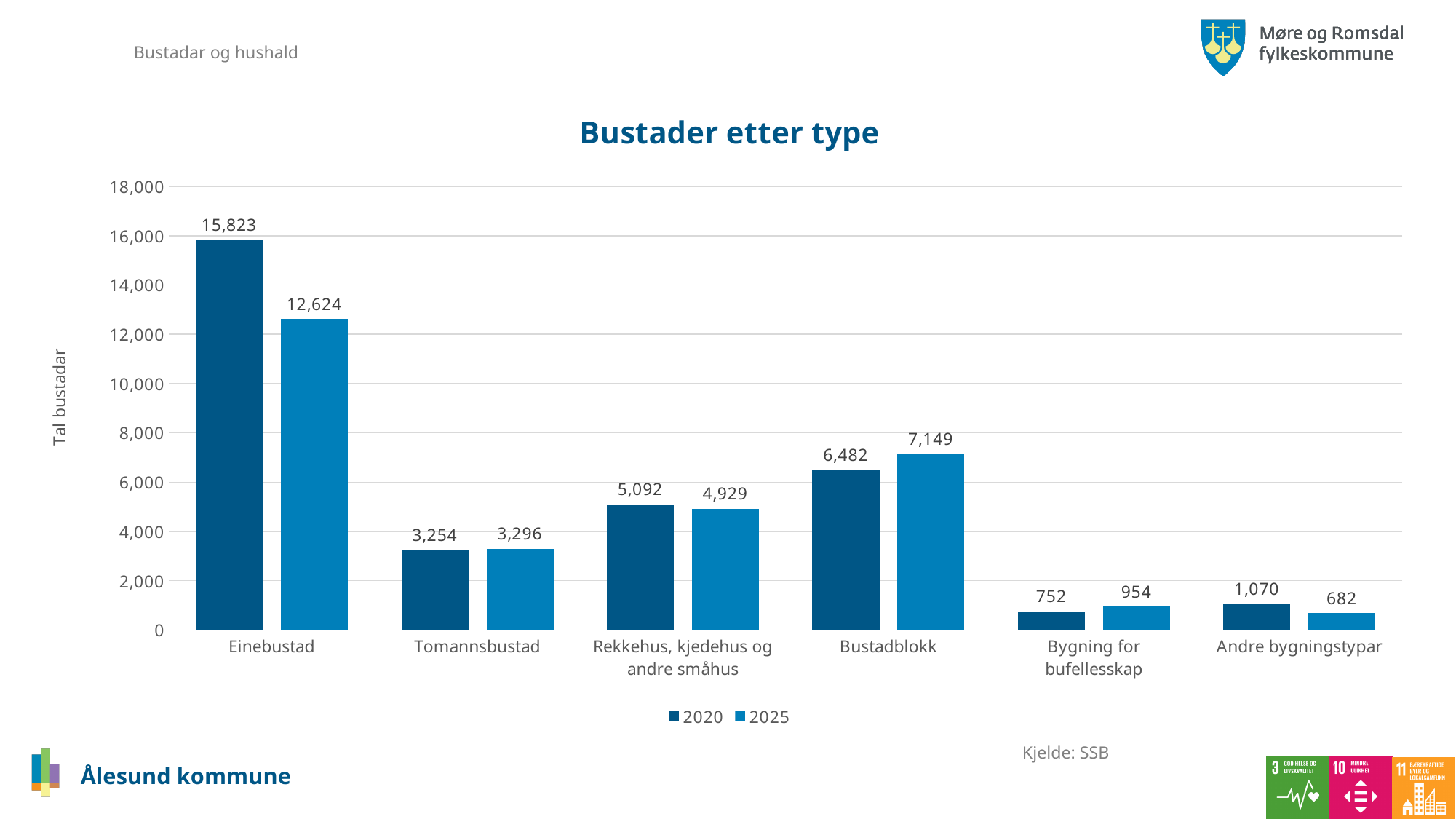
How many categories are shown on the x axis? 6 What is the title of the chart? Bustader etter type Which category has the highest value in 2025? Einebustad Is the 2020 value for Rekkehus, kjedehus og andre småhus greater or less than 4,000? greater How many series does the legend list? 2 What is the value for Bustadblokk in 2025? 7,149 What is the difference between the 2020 and 2025 values for Einebustad? 3,199 What is the value for Einebustad in 2020? 15,823 What kind of chart is shown on the slide? bar chart Which category has the lowest value in 2025? Andre bygningstypar What is the value for Bygning for bufellesskap in 2020? 752 Which is larger for Bustadblokk, the 2020 value or the 2025 value? 2025